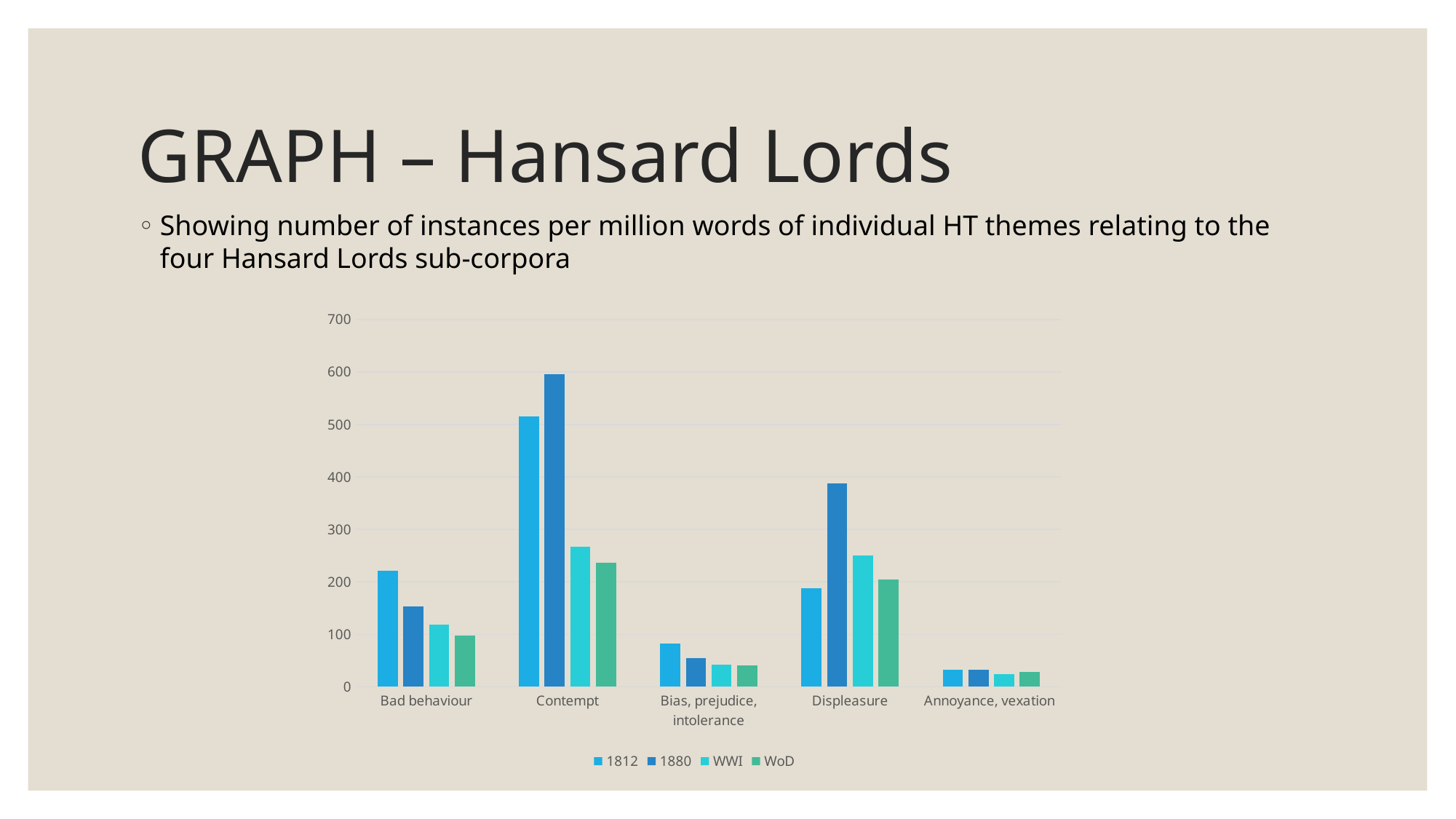
Is the value for 1812 in Bias, prejudice, intolerance greater or less than 100? less What are the four series named in the legend? 1812, 1880, WWI, WoD Which category has the highest value for the 1880 series? Contempt Is the value for 1880 in Contempt greater or less than 500? greater How many series does the legend list? 4 Which category has the lowest value for the 1812 series? Annoyance, vexation Is the value for 1880 in Displeasure greater or less than 300? greater What kind of chart is shown on the slide? bar chart How many categories are shown on the x axis? 5 Which series has the highest value in the Displeasure category? 1880 For Bad behaviour, which series has the larger value, 1812 or 1880? 1812 For Contempt, which series has the larger value, 1812 or 1880? 1880